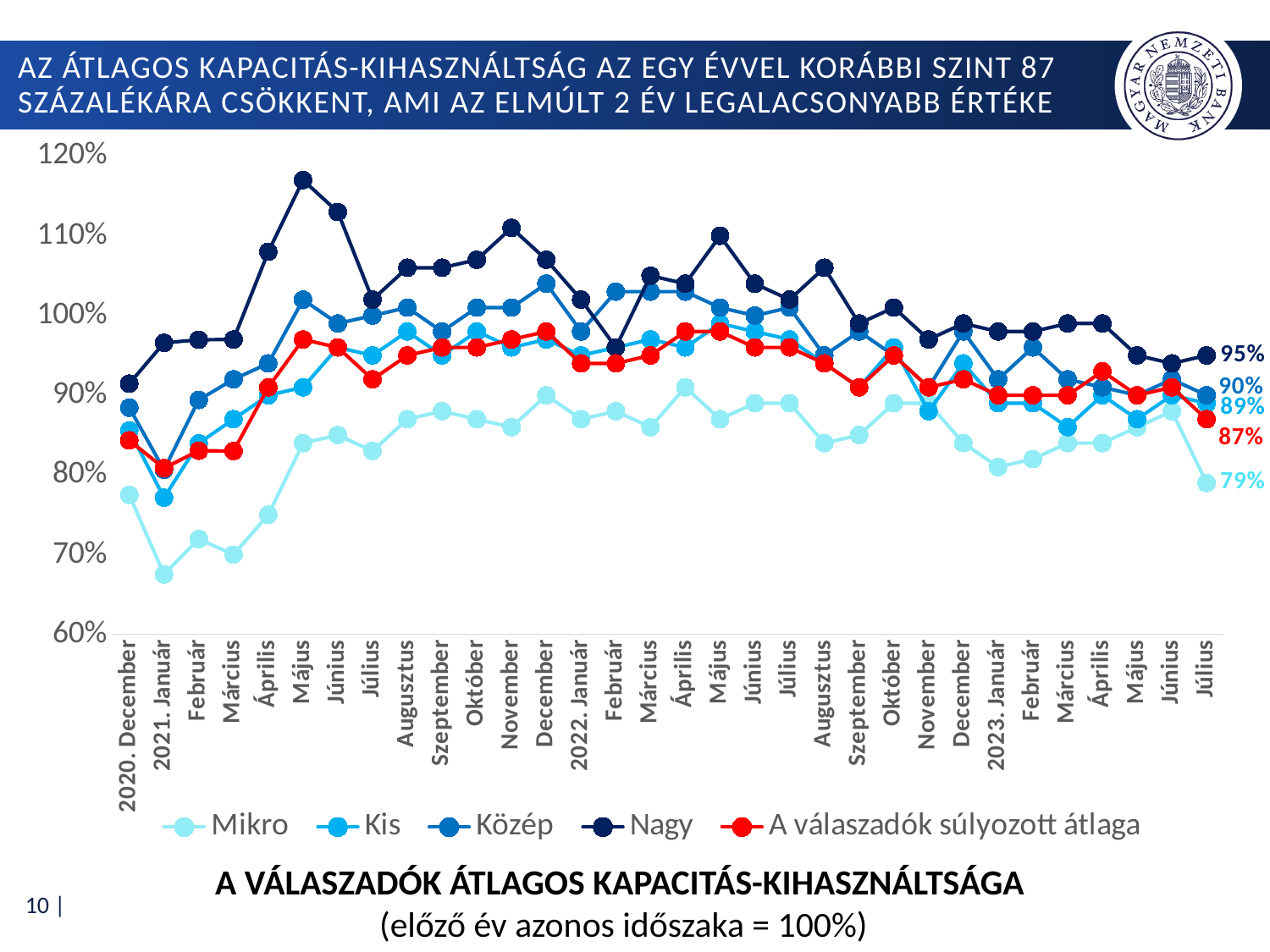
Is the value for Mikro in 2021 Január greater or less than 70%? less What is the value for A válaszadók súlyozott átlaga in 2023 Július? 87% How many series does the legend list? 5 Is the value for Nagy in 2021 Május greater or less than 110%? greater What is the difference between the Nagy and Mikro values in 2023 Július? 16 percentage points What is the value for Közép in 2023 Július? 90% What is the title shown below the chart's legend? A VÁLASZADÓK ÁTLAGOS KAPACITÁS-KIHASZNÁLTSÁGA What is the value for Mikro in 2023 Július? 79% Which series has the lowest value in 2023 Július? Mikro What kind of chart is shown on the slide? line chart What is the value for Kis in 2023 Július? 89% What is the value for Nagy in 2023 Július? 95%